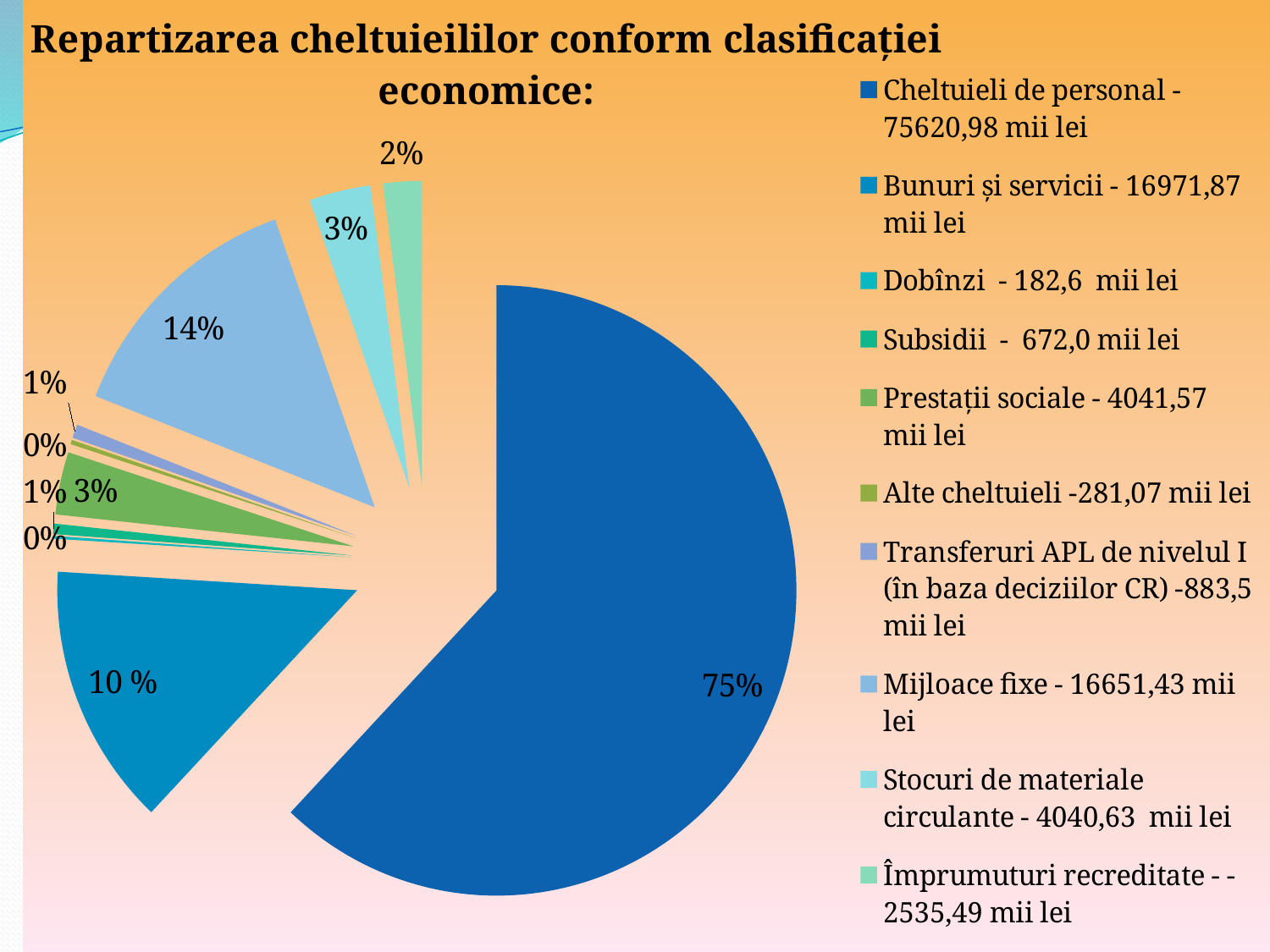
What share of the pie does Împrumuturi recreditate represent? 2% What share of the pie does Cheltuieli de personal represent? 75% What share of the pie does Bunuri și servicii represent? 10 % What kind of chart is shown on the slide? pie chart How many categories does the legend list? 10 According to the legend, what amount in mii lei is given for Dobînzi? 182,6 mii lei What is the title of the chart? Repartizarea cheltuieililor conform clasificației economice: Which category has the largest slice of the pie? Cheltuieli de personal According to the legend, what amount in mii lei is given for Cheltuieli de personal? 75620,98 mii lei What is the difference in percentage points between the Cheltuieli de personal slice and the Mijloace fixe slice? 61